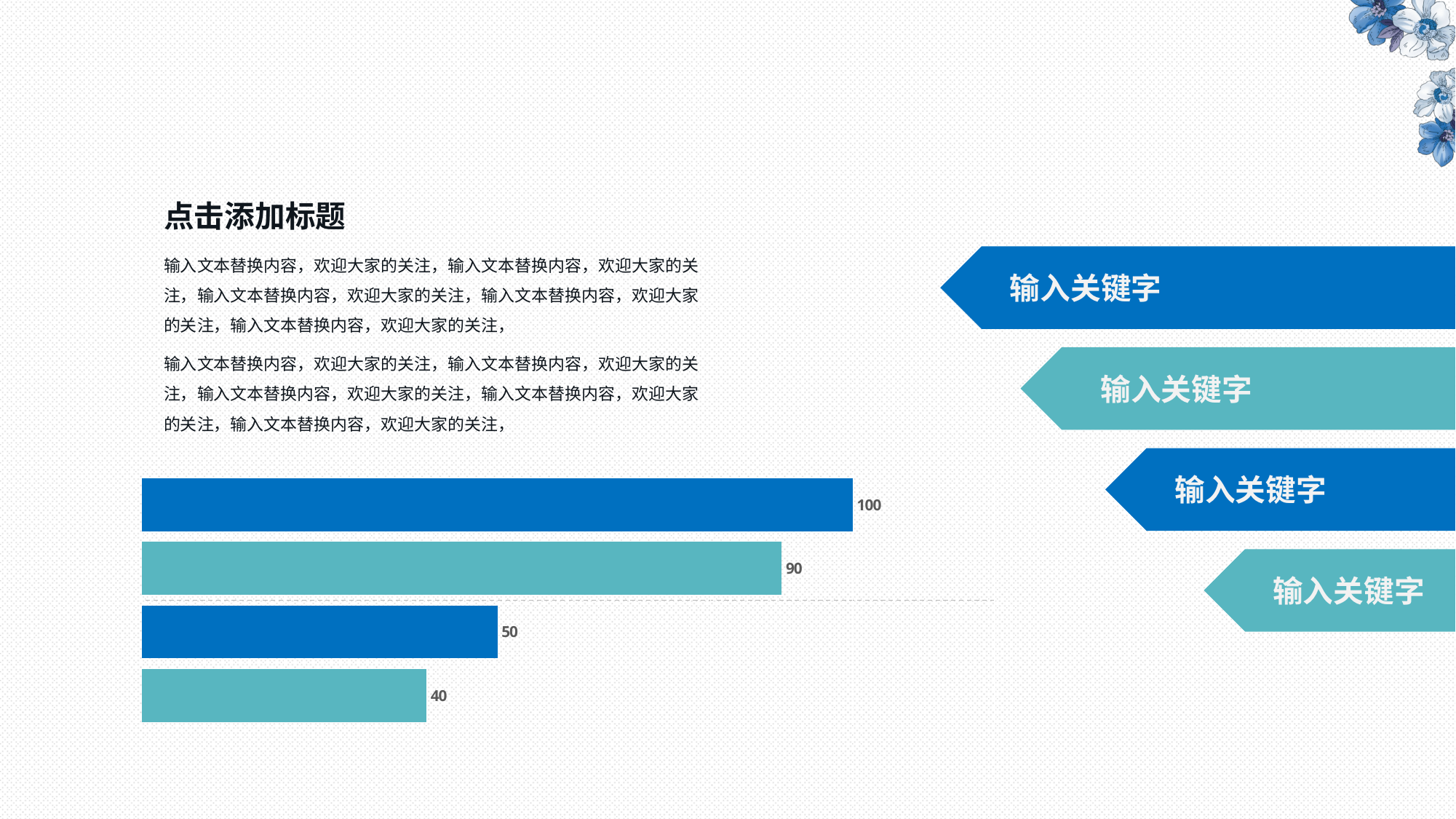
What kind of chart is shown on the slide? bar chart Which bar has the highest value? the top bar (100) What is the value of the second bar from the top? 90 Do the bar values increase or decrease from the top bar to the bottom bar? decrease Which is larger, the third bar from the top or the bottom bar? the third bar (50) Which bar has the lowest value? the bottom bar (40) What is the difference between the second bar (90) and the third bar (50)? 40 How many bars does the chart have? 4 What is the value of the top bar in the chart? 100 What is the value of the bottom bar in the chart? 40 What is the difference between the top bar and the bottom bar? 60 What is the value of the third bar from the top? 50